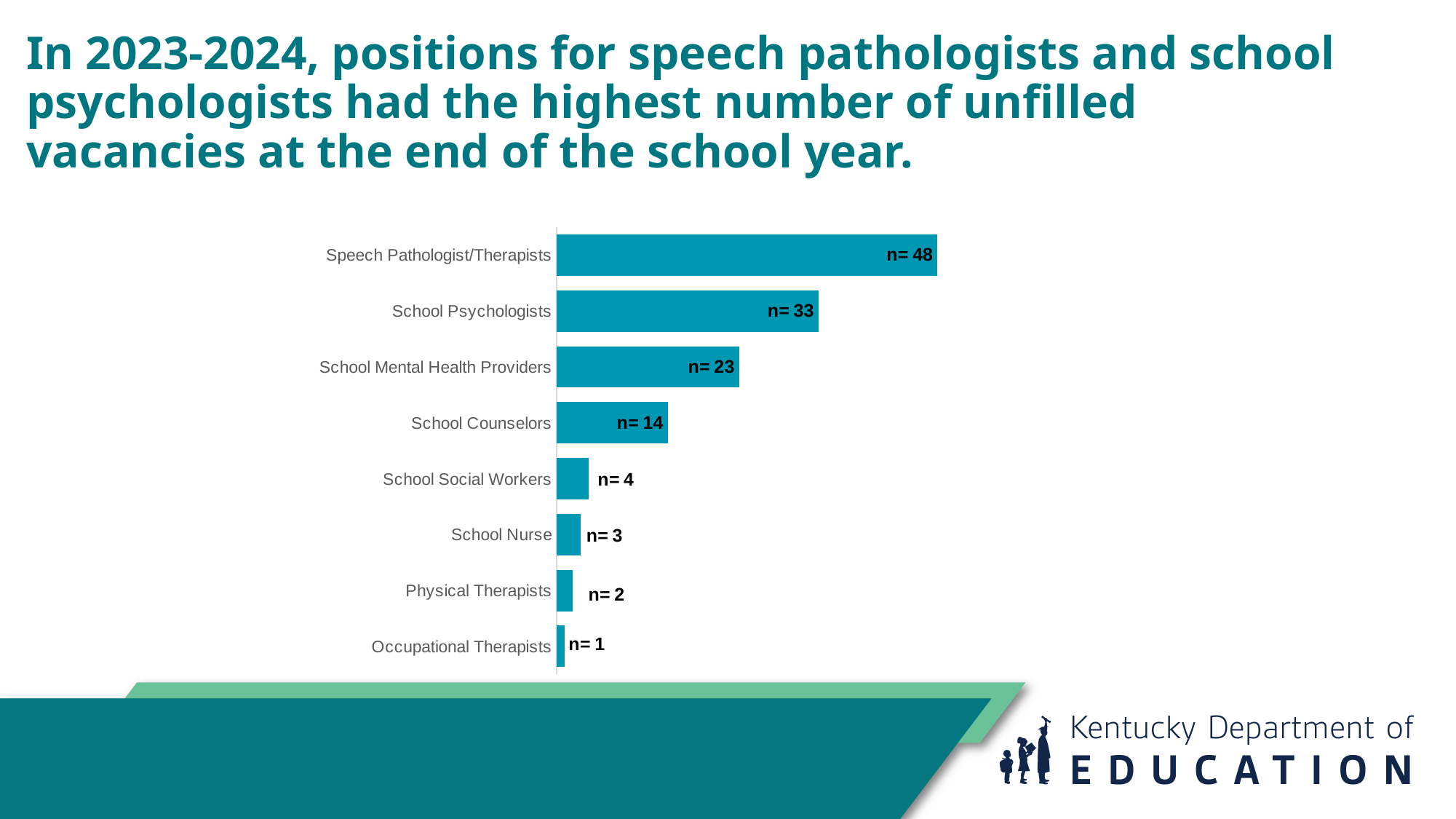
What is the difference between the unfilled vacancies for School Mental Health Providers and School Counselors? 9 What is the number of unfilled vacancies for School Nurse? 3 How many categories are shown in the chart? 8 What is the number of unfilled vacancies for School Psychologists? 33 What kind of chart is shown on the slide? Bar chart What is the number of unfilled vacancies for School Counselors? 14 Which has more unfilled vacancies, School Social Workers or Physical Therapists? School Social Workers Which category has the highest number of unfilled vacancies? Speech Pathologist/Therapists What is the number of unfilled vacancies for Speech Pathologist/Therapists? 48 What colour are the bars in the chart? Teal Which category has the lowest number of unfilled vacancies? Occupational Therapists What is the difference between the unfilled vacancies for Speech Pathologist/Therapists and School Psychologists? 15